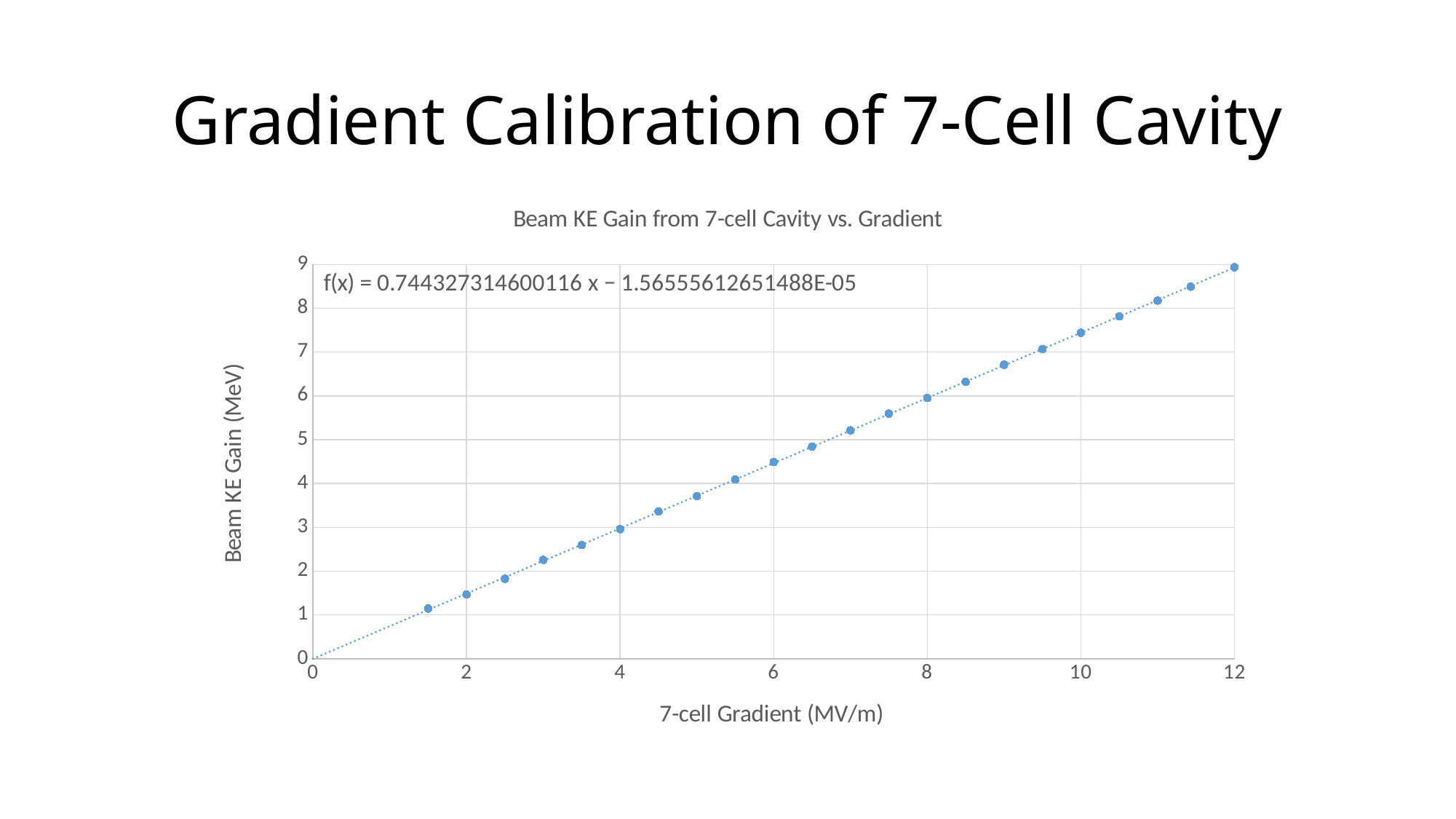
Is the Beam KE Gain at a gradient of 11 MV/m greater or less than 8? greater Is the Beam KE Gain at a gradient of 10 MV/m greater or less than 7? greater What kind of chart is shown on the slide? Scatter chart Which has the larger Beam KE Gain: a gradient of 5 MV/m or a gradient of 7 MV/m? 7 MV/m Is the Beam KE Gain at a gradient of 9 MV/m greater or less than 7? less At which 7-cell Gradient value is the Beam KE Gain highest? 12 What is the label of the y axis? Beam KE Gain (MeV) What is the slope of the fitted line shown in the equation on the chart? 0.744327314600116 What is the title of the chart? Beam KE Gain from 7-cell Cavity vs. Gradient Do the Beam KE Gain values rise or fall as the 7-cell Gradient increases? Rise